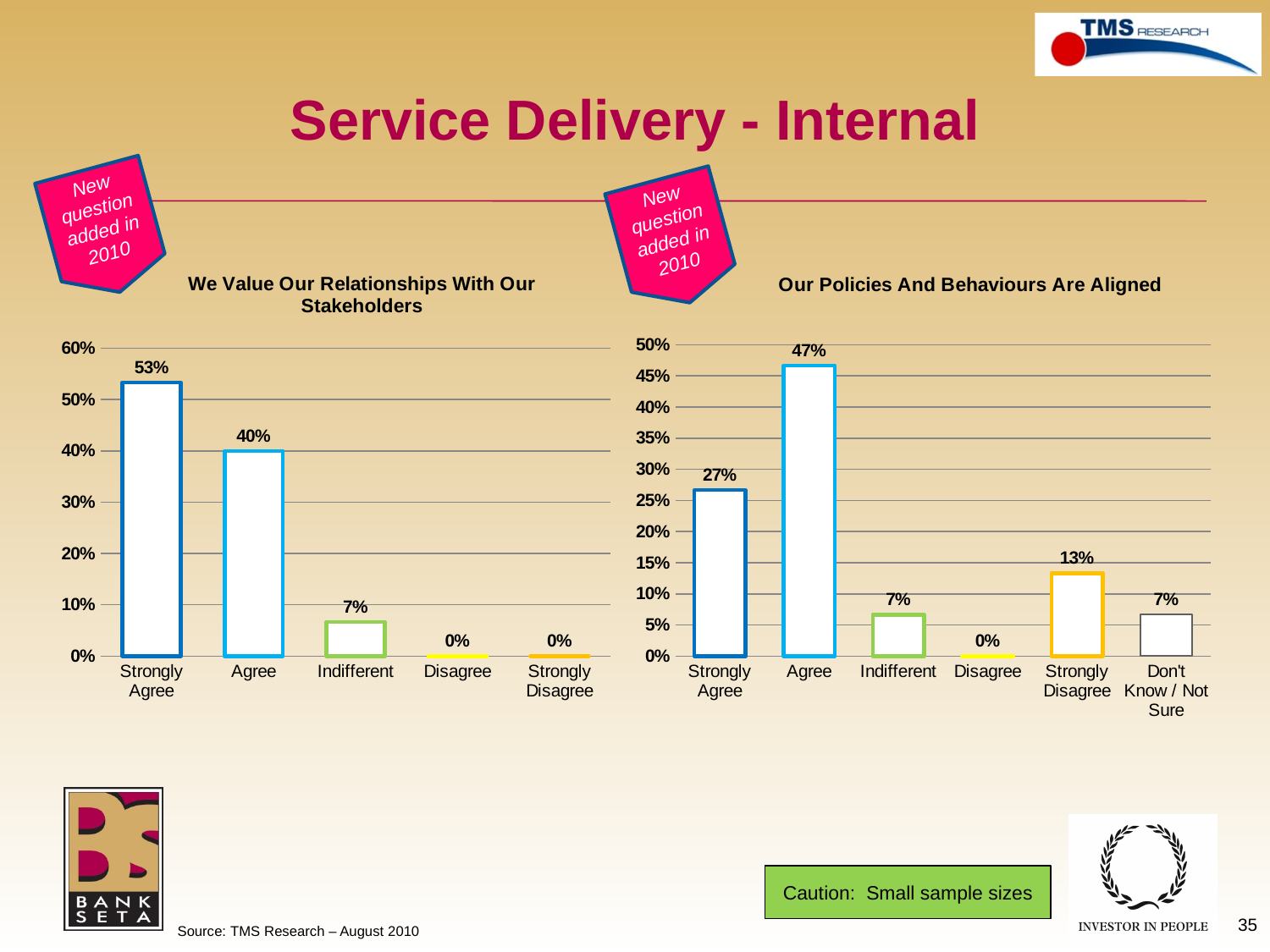
In the 'Our Policies And Behaviours Are Aligned' chart, what is the value for Agree? 47% In the 'We Value Our Relationships With Our Stakeholders' chart, what is the difference between Strongly Agree and Agree? 13% What type of chart is the 'Our Policies And Behaviours Are Aligned' chart? Bar chart In the 'Our Policies And Behaviours Are Aligned' chart, which is larger, Strongly Agree or Agree? Agree How many categories are shown in the 'Our Policies And Behaviours Are Aligned' chart? 6 In the 'We Value Our Relationships With Our Stakeholders' chart, what is the value for Strongly Agree? 53% In the 'Our Policies And Behaviours Are Aligned' chart, what is the value for Strongly Disagree? 13% How many categories are shown in the 'We Value Our Relationships With Our Stakeholders' chart? 5 In the 'Our Policies And Behaviours Are Aligned' chart, which category has the lowest value? Disagree In the 'We Value Our Relationships With Our Stakeholders' chart, what is the value for Indifferent? 7% In the 'We Value Our Relationships With Our Stakeholders' chart, which category has the highest value? Strongly Agree In the 'Our Policies And Behaviours Are Aligned' chart, what is the difference between Agree and Strongly Agree? 20%